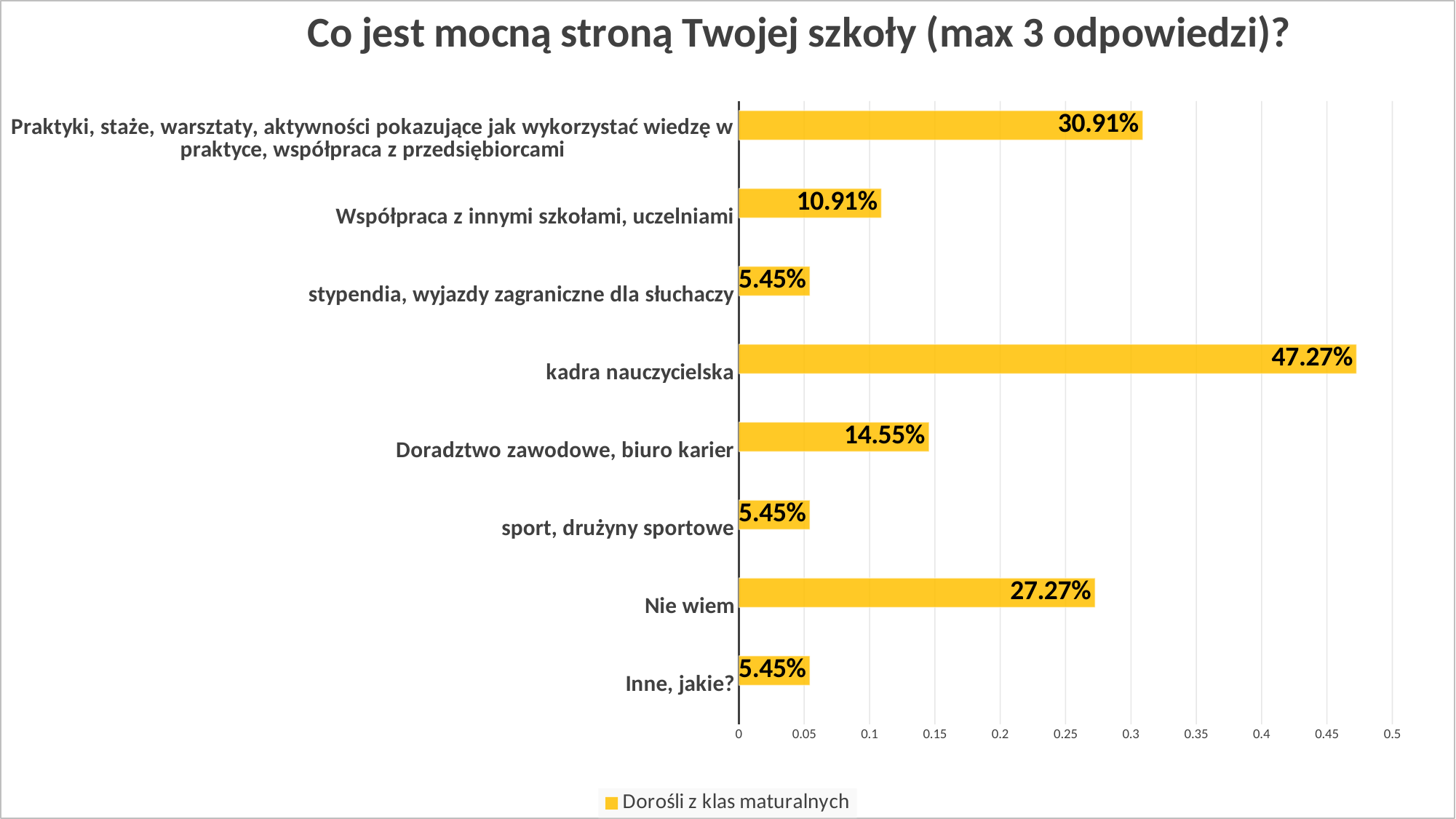
What is the name of the series shown in the legend? Dorośli z klas maturalnych What is the difference between the values for "kadra nauczycielska" and "Nie wiem"? 20.00% Which is larger: the value for "Praktyki, staże, warsztaty, aktywności pokazujące jak wykorzystać wiedzę w praktyce, współpraca z przedsiębiorcami" or the value for "Nie wiem"? Praktyki, staże, warsztaty, aktywności pokazujące jak wykorzystać wiedzę w praktyce, współpraca z przedsiębiorcami What is the value for "Doradztwo zawodowe, biuro karier"? 14.55% What is the value for "Nie wiem"? 27.27% Which category has the highest value? kadra nauczycielska What is the value for "kadra nauczycielska"? 47.27% How many categories are shown in the chart? 8 What is the value for "Współpraca z innymi szkołami, uczelniami"? 10.91% How many categories have a value of 5.45%? 3 What kind of chart is shown on the slide? bar chart How many series does the legend list? 1